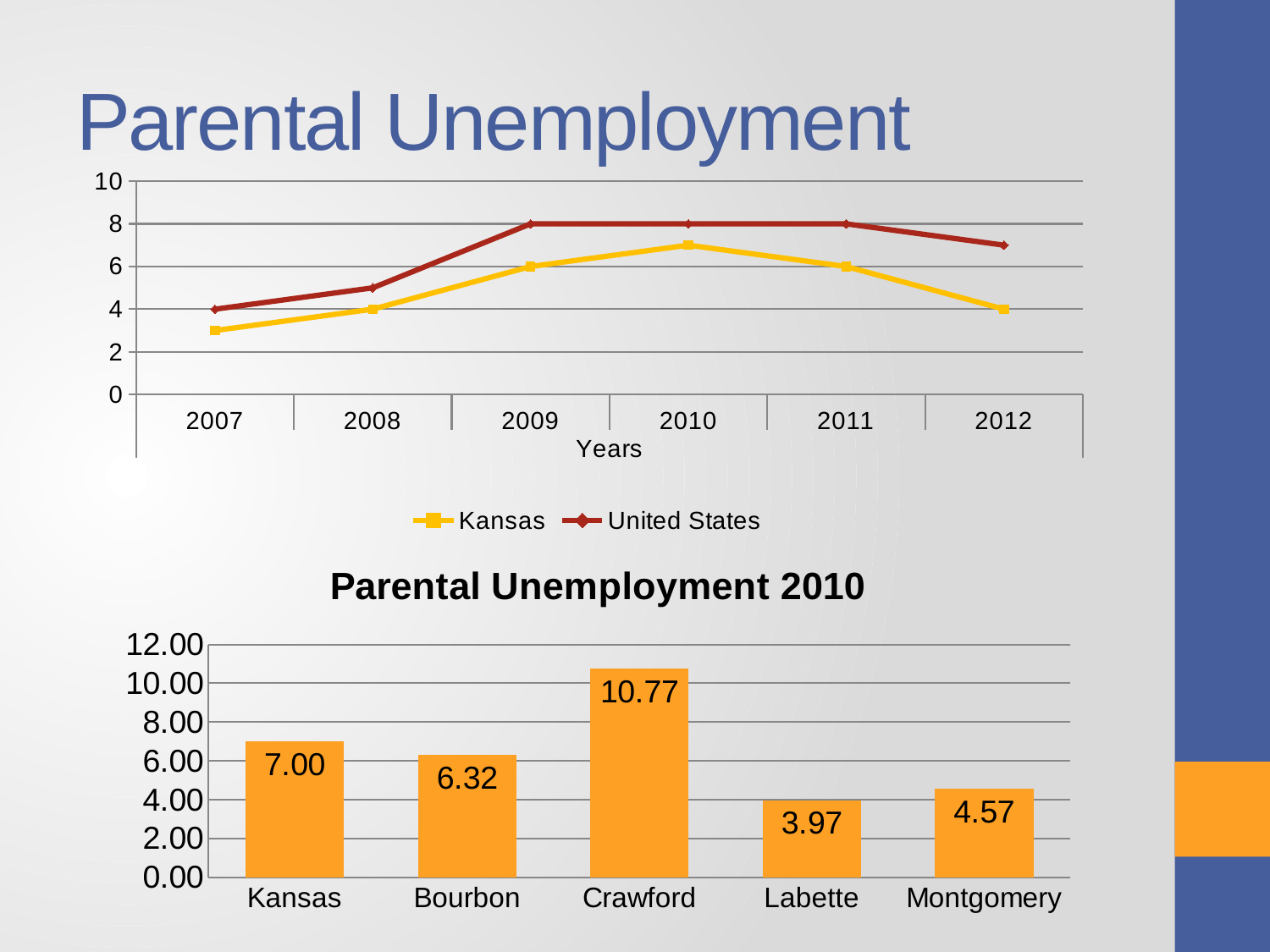
In the bottom chart titled Parental Unemployment 2010, what is the difference between the values for Kansas and Bourbon? 0.68 In the bottom chart titled Parental Unemployment 2010, which category has the highest value? Crawford In the bottom chart titled Parental Unemployment 2010, how many categories are shown? 5 In the bottom chart titled Parental Unemployment 2010, what is the value for Crawford? 10.77 In the top line chart, does the Kansas line rise or fall from 2010 to 2012? fall In the bottom chart titled Parental Unemployment 2010, which category has the lowest value? Labette In the bottom chart titled Parental Unemployment 2010, what is the value for Labette? 3.97 In the top line chart, what is the value for United States in 2009? 8 What kind of chart is the bottom chart titled Parental Unemployment 2010? bar chart In the bottom chart titled Parental Unemployment 2010, which is larger, the value for Montgomery or the value for Labette? Montgomery In the top line chart, how many series does the legend list? 2 In the top line chart, is the value for Kansas in 2010 greater or less than 6? greater